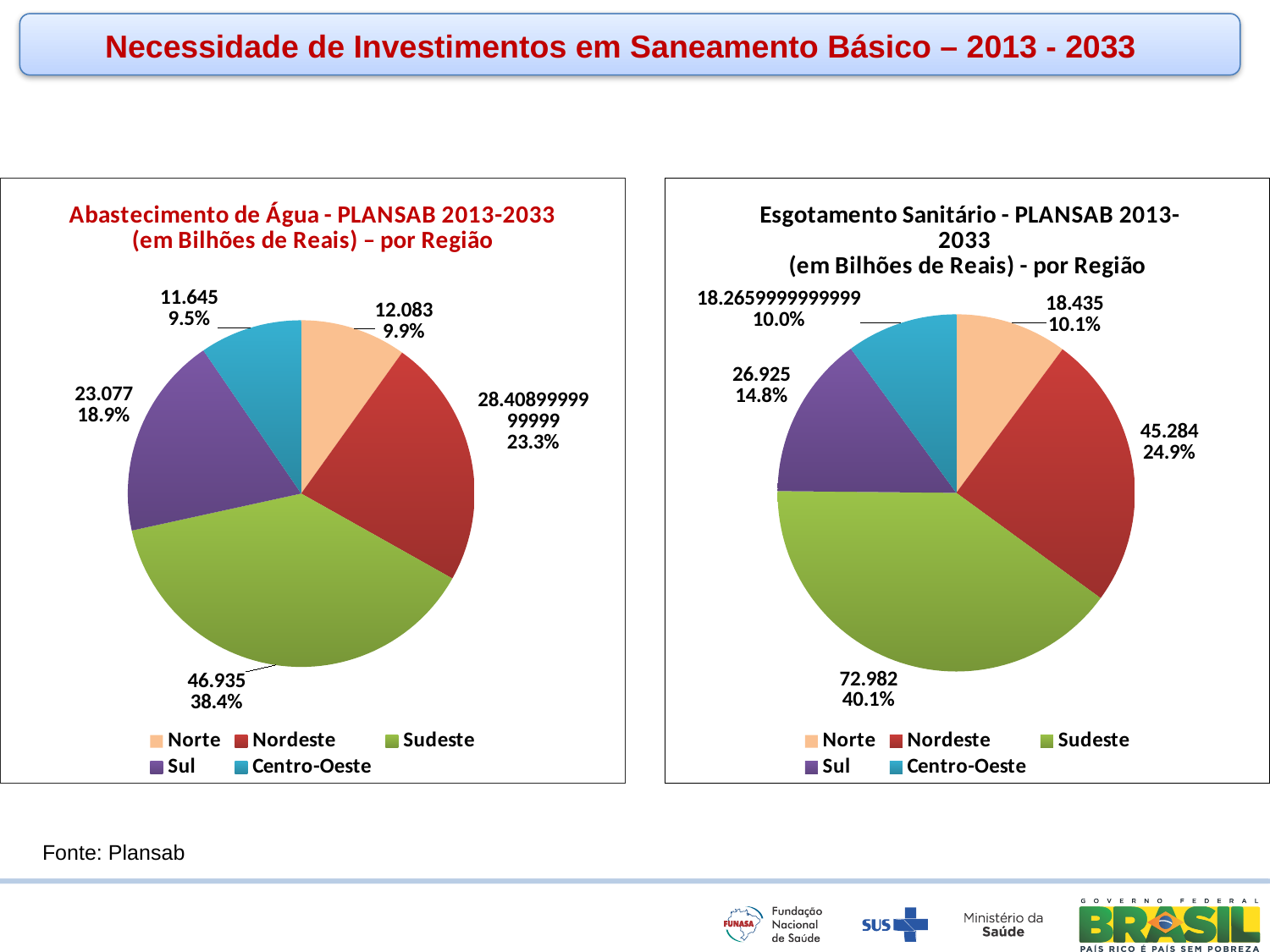
How many regions are shown in the 'Esgotamento Sanitário' chart? 5 In the 'Esgotamento Sanitário' chart, which is larger, the value for Sul or the value for Norte? Sul In the 'Esgotamento Sanitário' chart, what is the difference between the values for Sudeste and Nordeste? 27.698 In the 'Esgotamento Sanitário' chart, what is the value for Nordeste? 45.284 In the 'Abastecimento de Água' chart, which region has the largest slice? Sudeste In the 'Abastecimento de Água' chart, which is larger, the value for Nordeste or the value for Sul? Nordeste What kind of chart is the 'Abastecimento de Água - PLANSAB 2013-2033' chart? pie chart In the 'Abastecimento de Água' chart, what share of the pie does Sul represent? 18.9% In the 'Esgotamento Sanitário' chart, what share of the pie does Sudeste represent? 40.1% In the 'Esgotamento Sanitário' chart, which colour represents Sudeste in the legend? green In the 'Abastecimento de Água' chart, what is the difference between the values for Sudeste and Sul? 23.858 In the 'Abastecimento de Água' chart, what is the value for Sudeste? 46.935